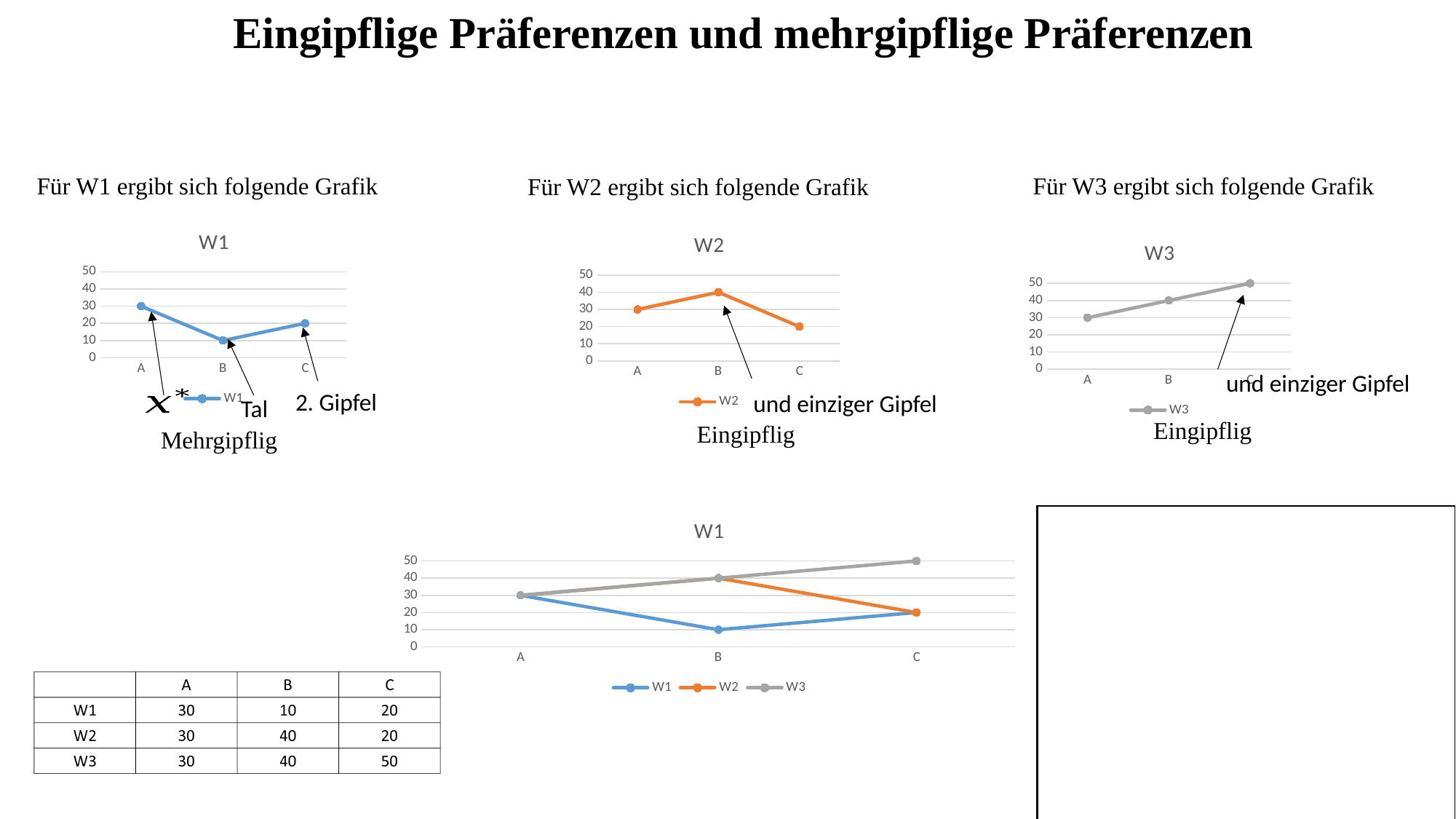
What type of chart is the top-left chart titled W1? line chart In the top-right chart titled W3, what is the value for C? 50 In the top-middle chart titled W2, which category has the lowest value? C In the bottom chart titled W1, what is the difference between the W3 value and the W1 value at C? 30 How many series does the legend of the bottom chart titled W1 list? 3 In the bottom chart titled W1, what colour is the W2 series line? orange In the top-right chart titled W3, do the values rise or fall from A to C? rise In the bottom chart titled W1, which is larger at B: the W2 value or the W1 value? W2 In the top-left chart titled W1, what is the value for B? 10 In the top-left chart titled W1, which category has the highest value? A How many categories are shown on the x axis of the bottom chart titled W1? 3 In the top-middle chart titled W2, what is the value for B? 40